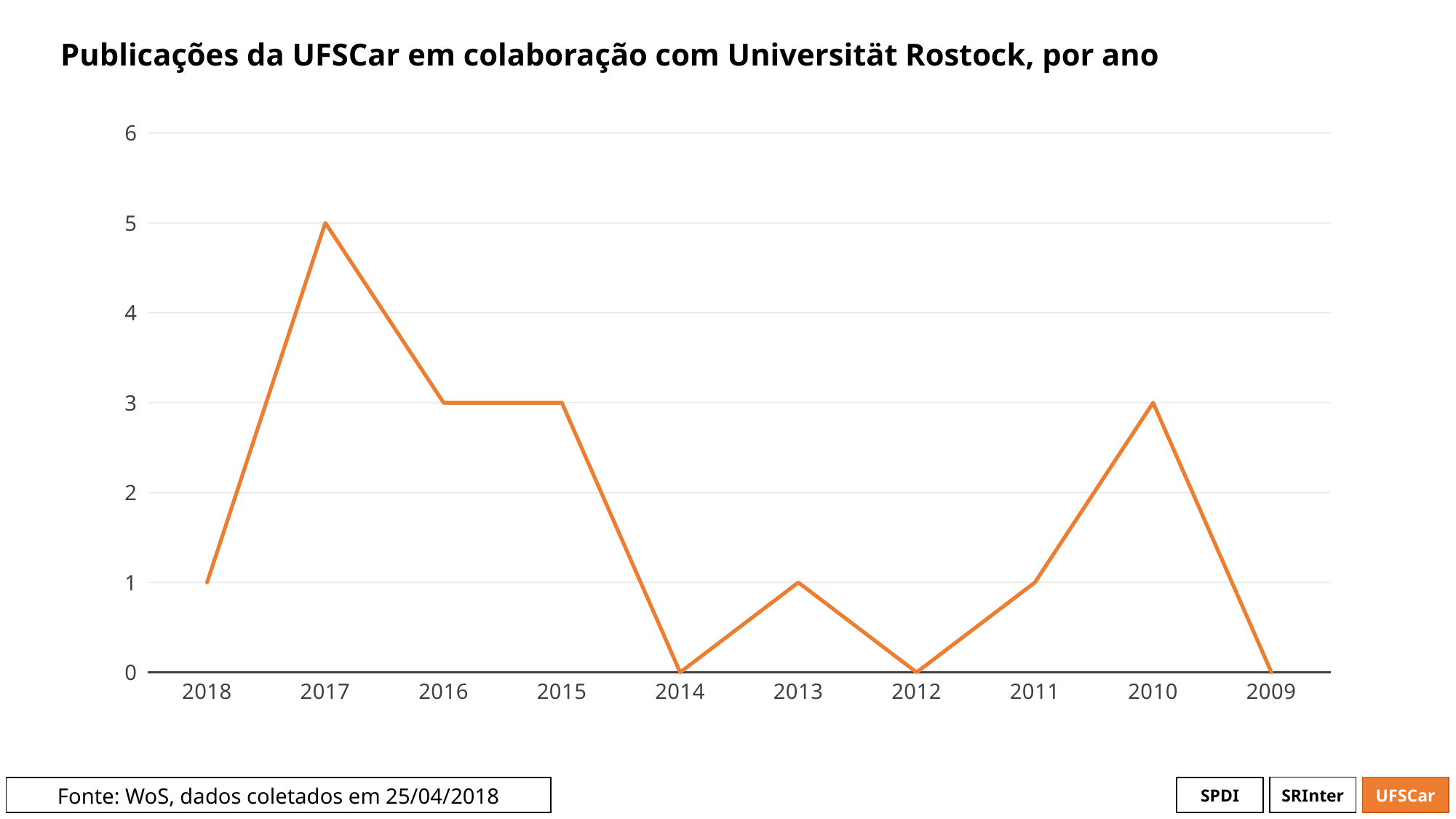
What is the value for 2018? 1 What is the difference between the values for 2017 and 2016? 2 Which year has the highest value? 2017 What kind of chart is shown on the slide? line chart Does the line rise or fall from 2018 to 2017? rise What is the value for 2010? 3 How many years are plotted on the x axis? 10 What is the title of the chart? Publicações da UFSCar em colaboração com Universität Rostock, por ano What is the value for 2017? 5 Which is larger, the value for 2010 or the value for 2011? 2010 Is the value for 2017 greater or less than 4? greater What is the value for 2016? 3